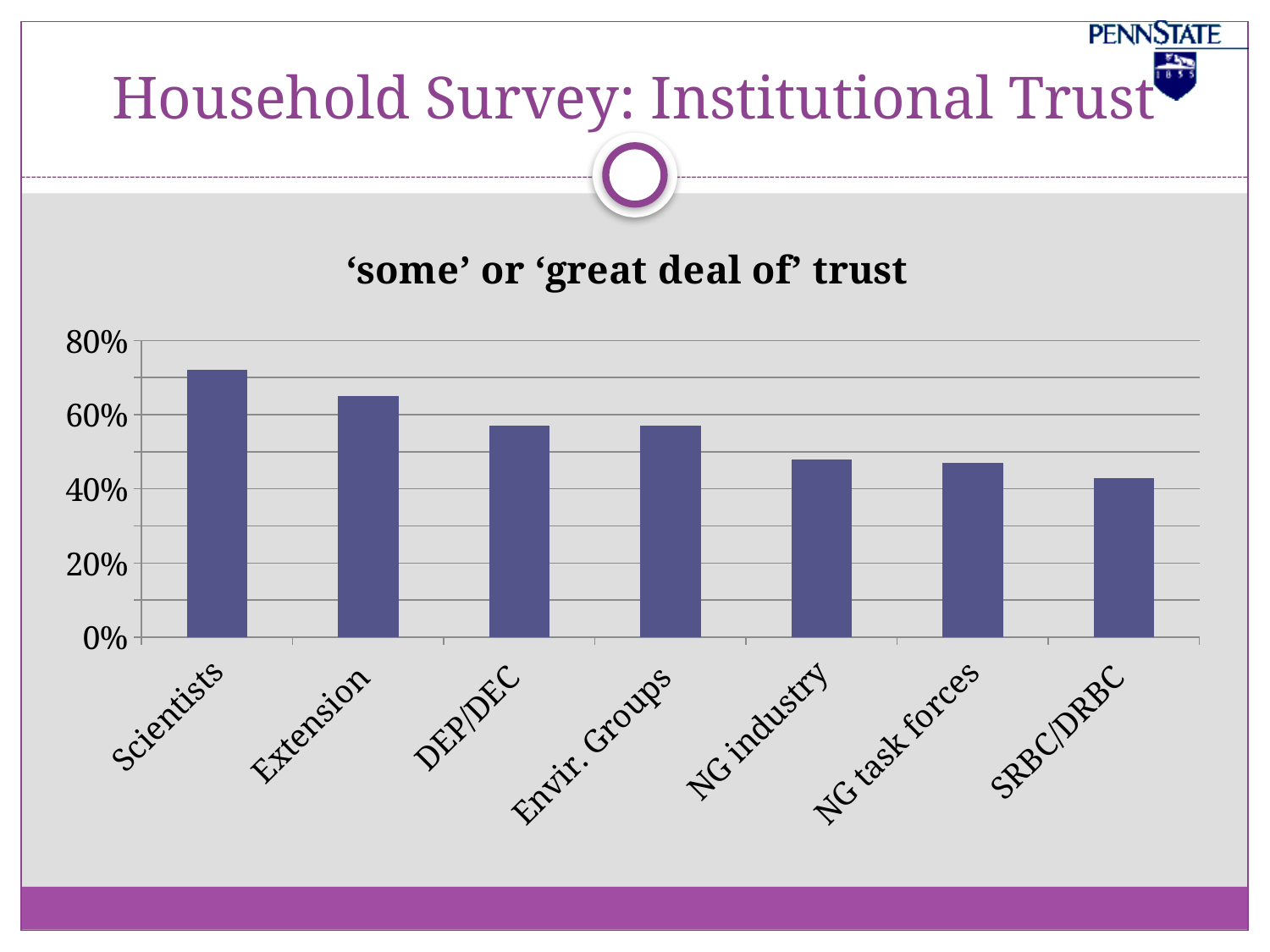
Do the values generally rise or fall moving from left to right along the x axis? fall Which category has the highest value in the chart? Scientists What is the title of the chart? 'some' or 'great deal of' trust Is the value for NG industry greater or less than 40%? greater Which is larger, the value for NG task forces or the value for Extension? Extension How many categories are shown on the x axis of the chart? 7 Which is larger, the value for Scientists or the value for Extension? Scientists Is the value for SRBC/DRBC greater or less than 60%? less What kind of chart is shown on the slide? bar chart Is the value for Scientists greater or less than 60%? greater Which category has the lowest value in the chart? SRBC/DRBC